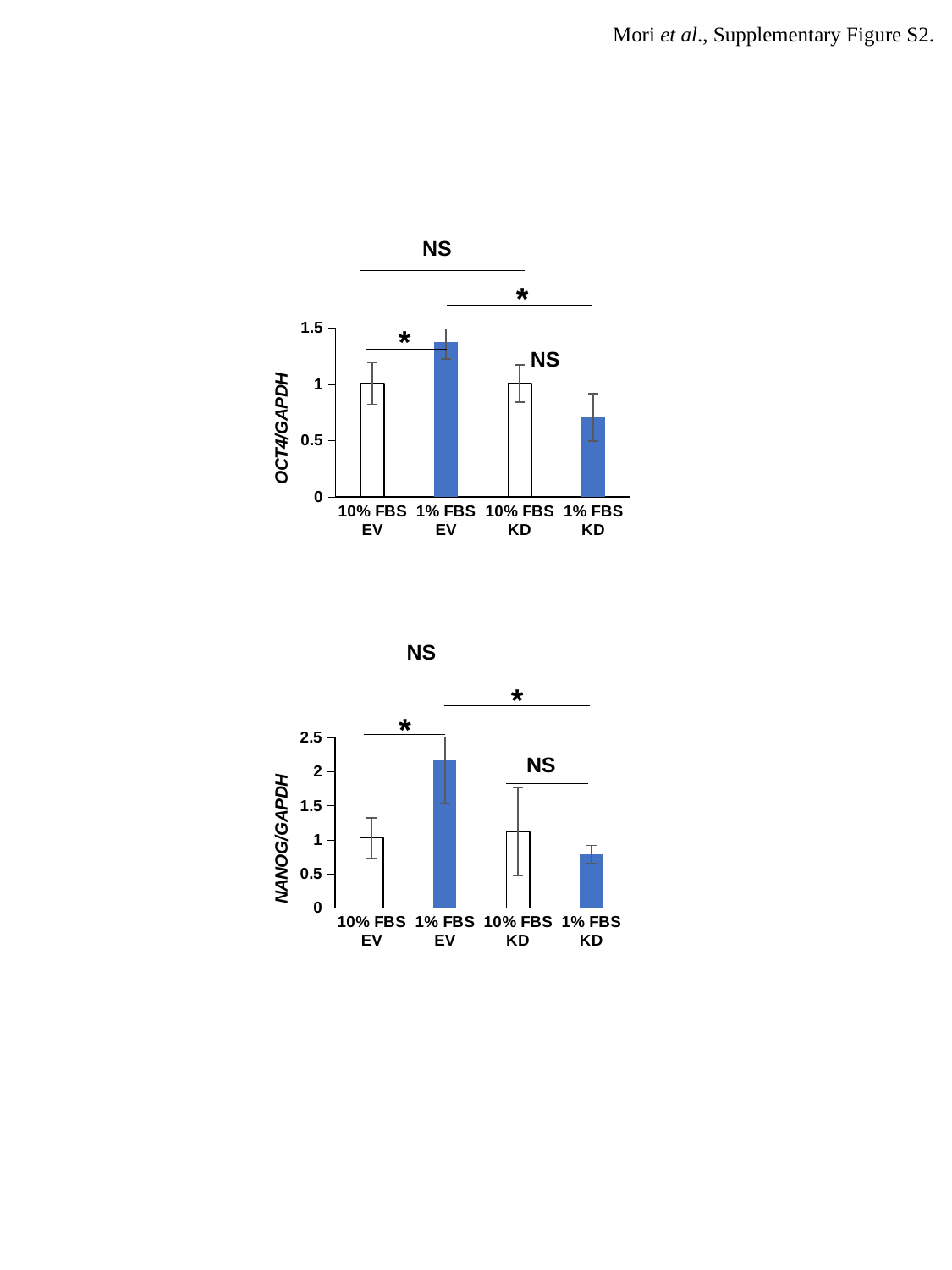
In the top chart (OCT4/GAPDH), is the value for 1% FBS EV greater or less than 1? greater What is the y-axis label of the bottom chart? NANOG/GAPDH In the bottom chart (NANOG/GAPDH), which condition has the lowest value? 1% FBS KD In the bottom chart (NANOG/GAPDH), which is larger: 1% FBS EV or 10% FBS KD? 1% FBS EV In the bottom chart (NANOG/GAPDH), which condition has the highest value? 1% FBS EV In the top chart (OCT4/GAPDH), how many bars are plotted? 4 In the top chart (OCT4/GAPDH), which is larger: 1% FBS EV or 1% FBS KD? 1% FBS EV What kind of chart is the top chart (OCT4/GAPDH)? bar chart In the top chart (OCT4/GAPDH), which condition has the lowest value? 1% FBS KD In the bottom chart (NANOG/GAPDH), is the value for 1% FBS EV greater or less than 1.5? greater In the top chart (OCT4/GAPDH), which condition has the highest value? 1% FBS EV In the top chart (OCT4/GAPDH), is the value for 1% FBS KD greater or less than 1? less